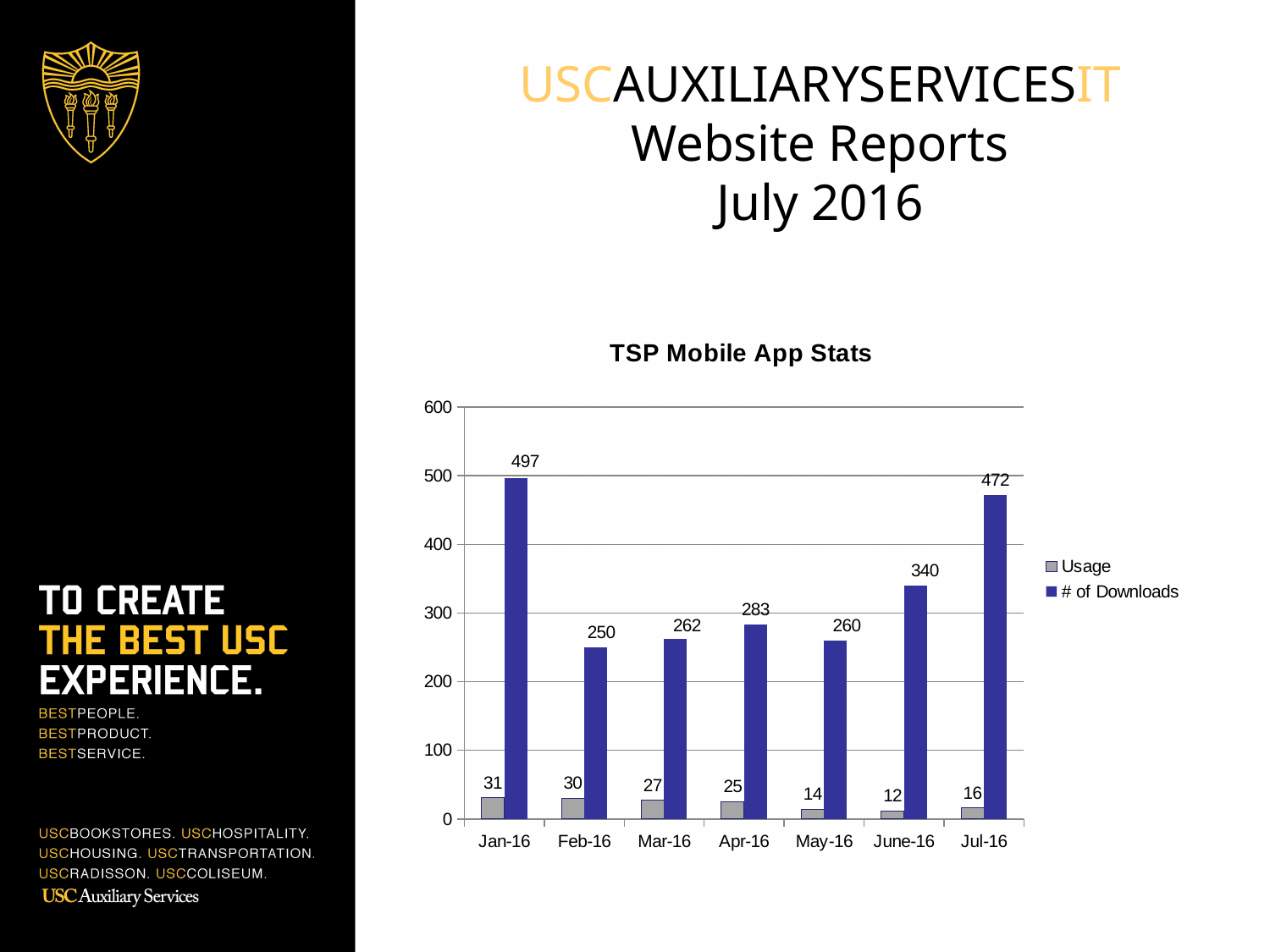
Which month has the highest number of downloads? Jan-16 Which month has the lowest Usage value? June-16 What is the title of the chart? TSP Mobile App Stats What is the difference between the Usage values for Jan-16 and Jul-16? 15 How many series does the legend list? 2 What is the Usage value for May-16? 14 What is the number of downloads for Jan-16? 497 What kind of chart is shown on the slide? bar chart How many months are shown on the x axis? 7 What is the difference in number of downloads between Jul-16 and June-16? 132 Which month has more downloads, Apr-16 or May-16? Apr-16 Is the number of downloads for Feb-16 greater or less than 300? less